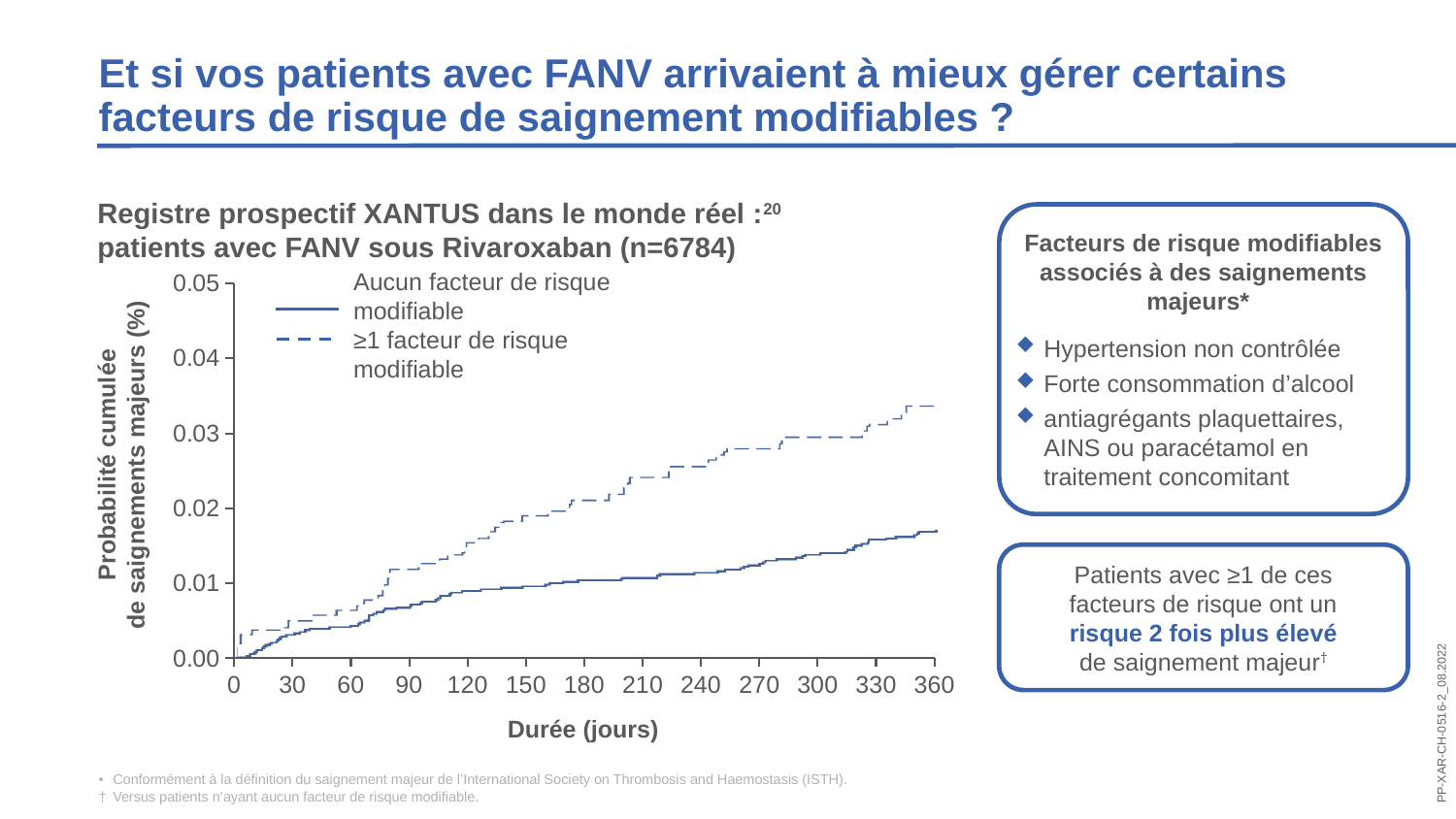
Is the value for 'Aucun facteur de risque modifiable' at 90 days greater or less than 0.01? less How many series does the chart legend list? 2 At 360 days, which series has the higher cumulative probability: 'Aucun facteur de risque modifiable' or '≥1 facteur de risque modifiable'? ≥1 facteur de risque modifiable Is the value for '≥1 facteur de risque modifiable' at 270 days greater or less than 0.02? greater How many tick marks are labelled on the x axis of the chart? 13 What is the label of the x axis of the chart? Durée (jours) Is the value for 'Aucun facteur de risque modifiable' at 360 days greater or less than 0.02? less Which series is plotted with a dashed line? ≥1 facteur de risque modifiable Do the values of the '≥1 facteur de risque modifiable' series rise or fall as the duration increases? rise What kind of chart is shown on the slide? line chart